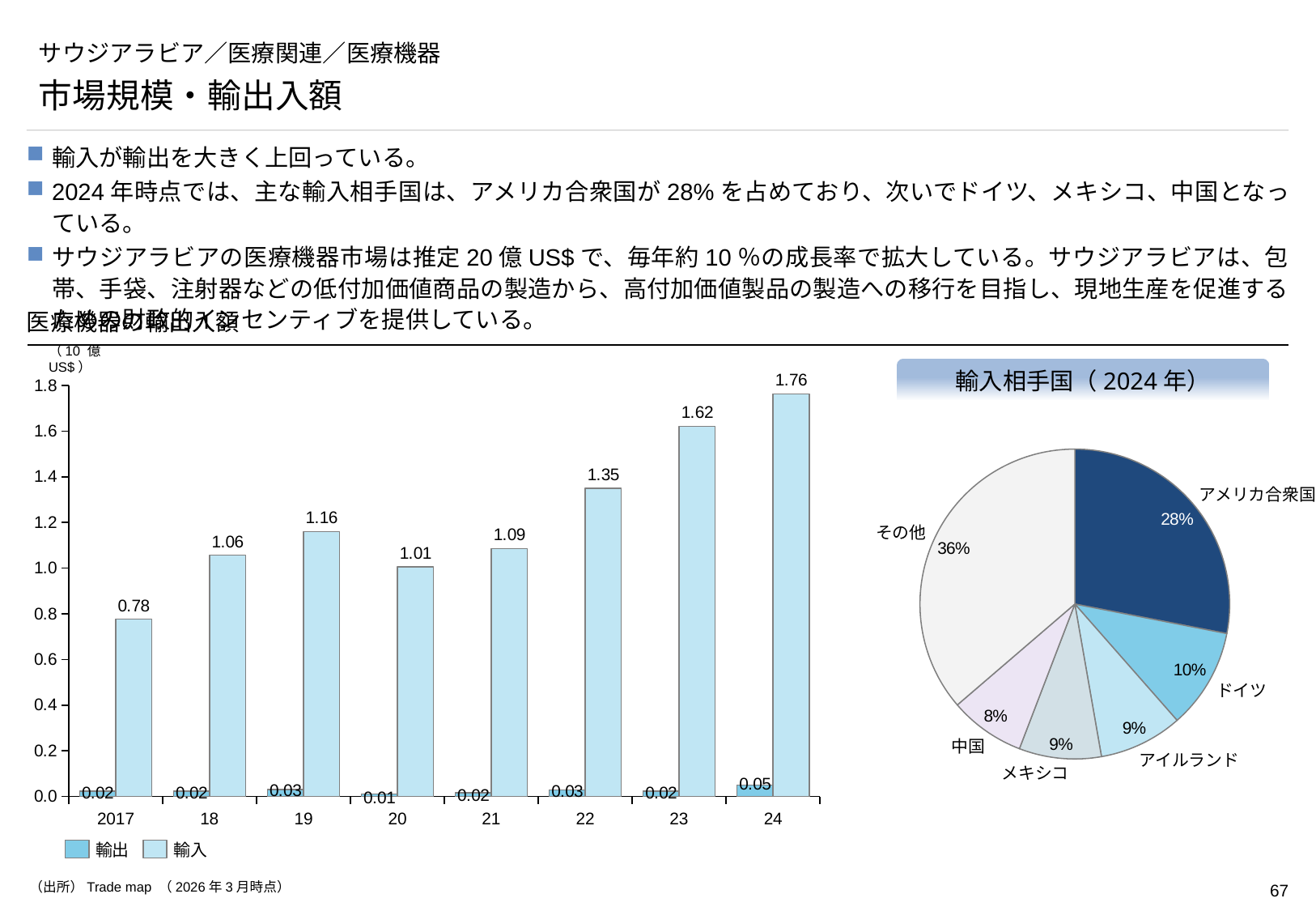
左の棒グラフで、2024年の輸入の値はいくらですか？ 1.76 左の棒グラフの凡例には、いくつの系列がありますか？ 2 右の円グラフ「輸入相手国（2024年）」には、いくつの区分がありますか？ 6 左の棒グラフで、2017年の輸入の値はいくらですか？ 0.78 左の棒グラフで、輸入が最も少ない年はどれですか？ 2017 右の円グラフ「輸入相手国（2024年）」で、アメリカ合衆国の割合はいくらですか？ 28% 左の棒グラフは、どのような種類のグラフですか？ 棒グラフ 左の棒グラフで、2023年と2022年の輸入の差はいくらですか？ 0.27 左の棒グラフで、2019年と2020年では、どちらの輸入が多いですか？ 2019年 左の棒グラフで、輸入が最も多い年はどれですか？ 24 左の棒グラフで、2024年の輸出の値はいくらですか？ 0.05 右の円グラフ「輸入相手国（2024年）」で、ドイツと中国の割合の差はいくらですか？ 2%